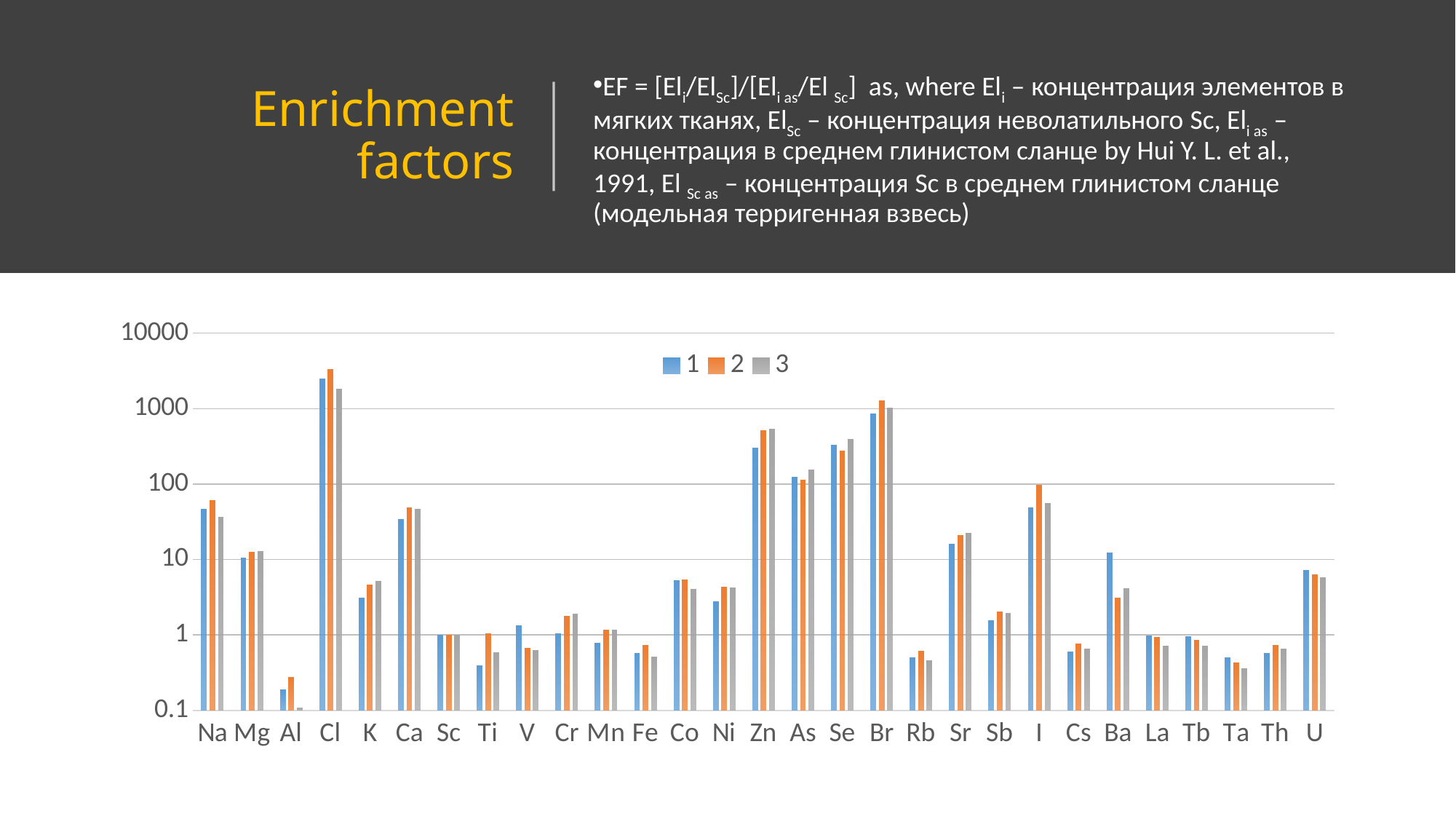
For Ba, which series has the larger value, series 1 or series 2? series 1 Which element has the highest bars in the chart? Cl Is the value for Br in series 1 greater or less than 100? greater What kind of chart is shown on the slide? bar chart Is the value for Cl in series 2 greater or less than 1000? greater How many element categories are shown on the x axis of the chart? 29 Is the value for Ta in series 2 greater or less than 1? less For Zn, which series has the larger value, series 1 or series 3? series 3 How many series does the chart legend list? 3 What are the entries listed in the chart legend? 1, 2, 3